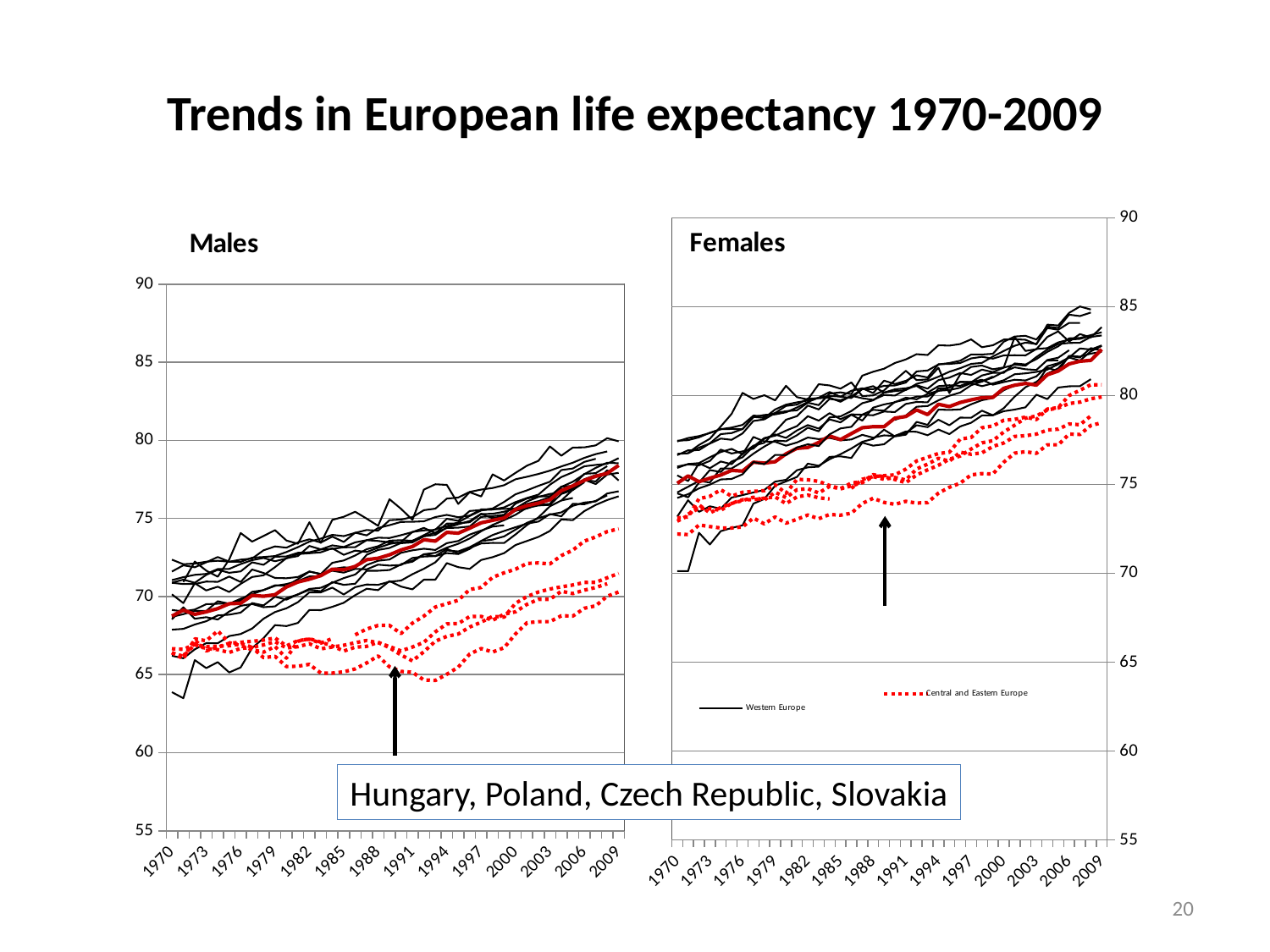
What kind of chart is the Males chart? line chart In the Females chart, are the Central and Eastern Europe values in 1970 greater or less than 75? less In the Females chart, do the Central and Eastern Europe lines rise or fall from 1970 to 2009? rise In the Males chart, are the Western Europe values in 2009 greater or less than 75? greater How many series does the legend on the Females chart list? 2 In the Males chart in 2009, which group has higher values: Western Europe or Central and Eastern Europe? Western Europe In the Females chart, are the Western Europe values in 2009 greater or less than 80? greater In the Females chart, which legend entry is drawn with a dotted red line? Central and Eastern Europe What kind of chart is the Females chart? line chart In the Males chart, do the Western Europe lines rise or fall from 1970 to 2009? rise What is the title of the slide containing the two charts? Trends in European life expectancy 1970-2009